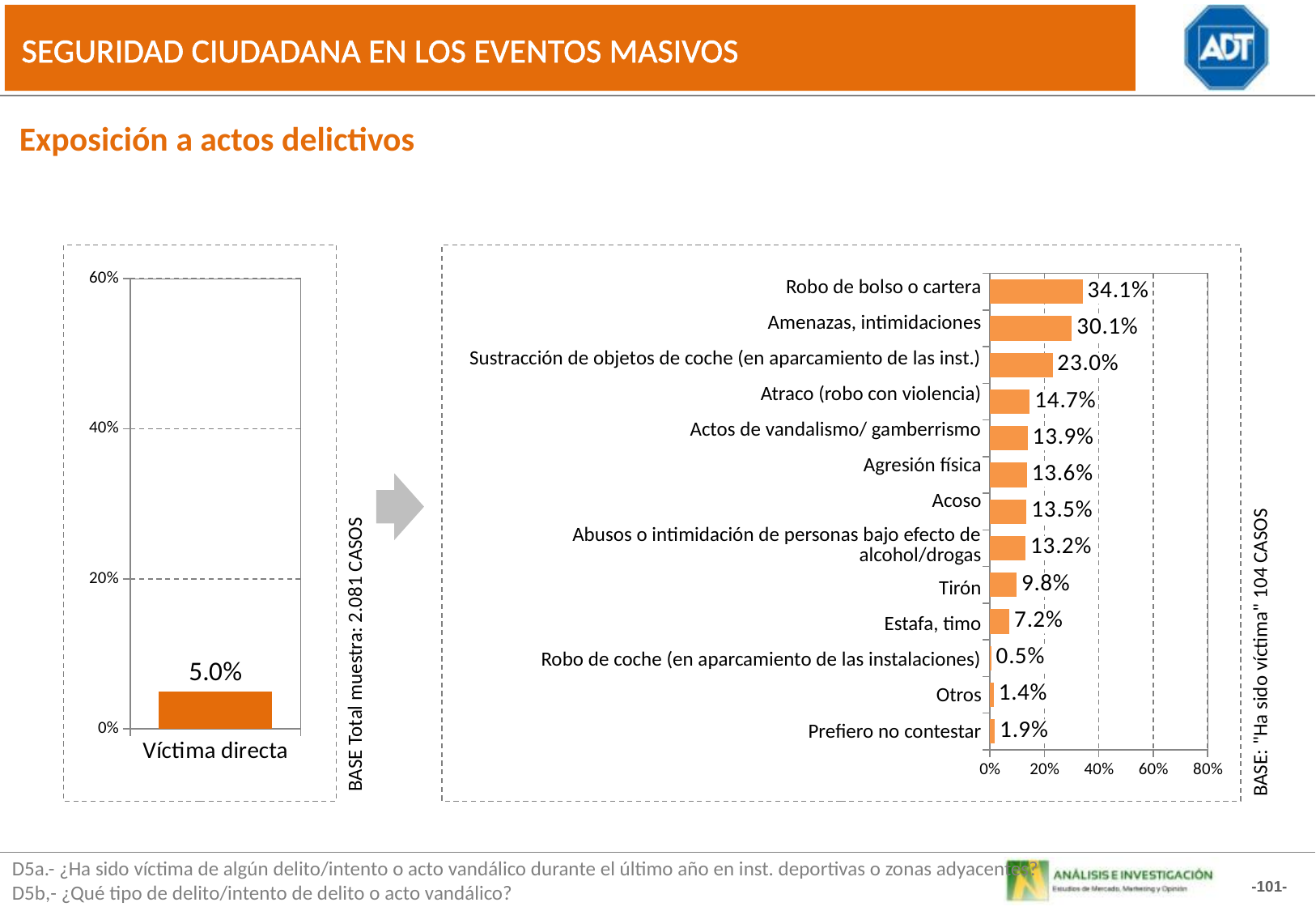
In the right chart, what is the difference between Robo de bolso o cartera and Amenazas, intimidaciones? 4.0% In the right chart, which is larger: Atraco (robo con violencia) or Estafa, timo? Atraco (robo con violencia) In the right chart, is the value for Amenazas, intimidaciones greater or less than 20%? greater What kind of chart is the right chart? Bar chart In the right chart, what is the value for Robo de bolso o cartera? 34.1% In the right chart, what is the value for Tirón? 9.8% In the left chart, is the value for Víctima directa greater or less than 20%? less In the left chart, what is the value for Víctima directa? 5.0% In the right chart, what is the value for Sustracción de objetos de coche (en aparcamiento de las inst.)? 23.0% How many categories are shown in the right chart? 13 In the right chart, which category has the lowest value? Robo de coche (en aparcamiento de las instalaciones) In the right chart, which category has the highest value? Robo de bolso o cartera